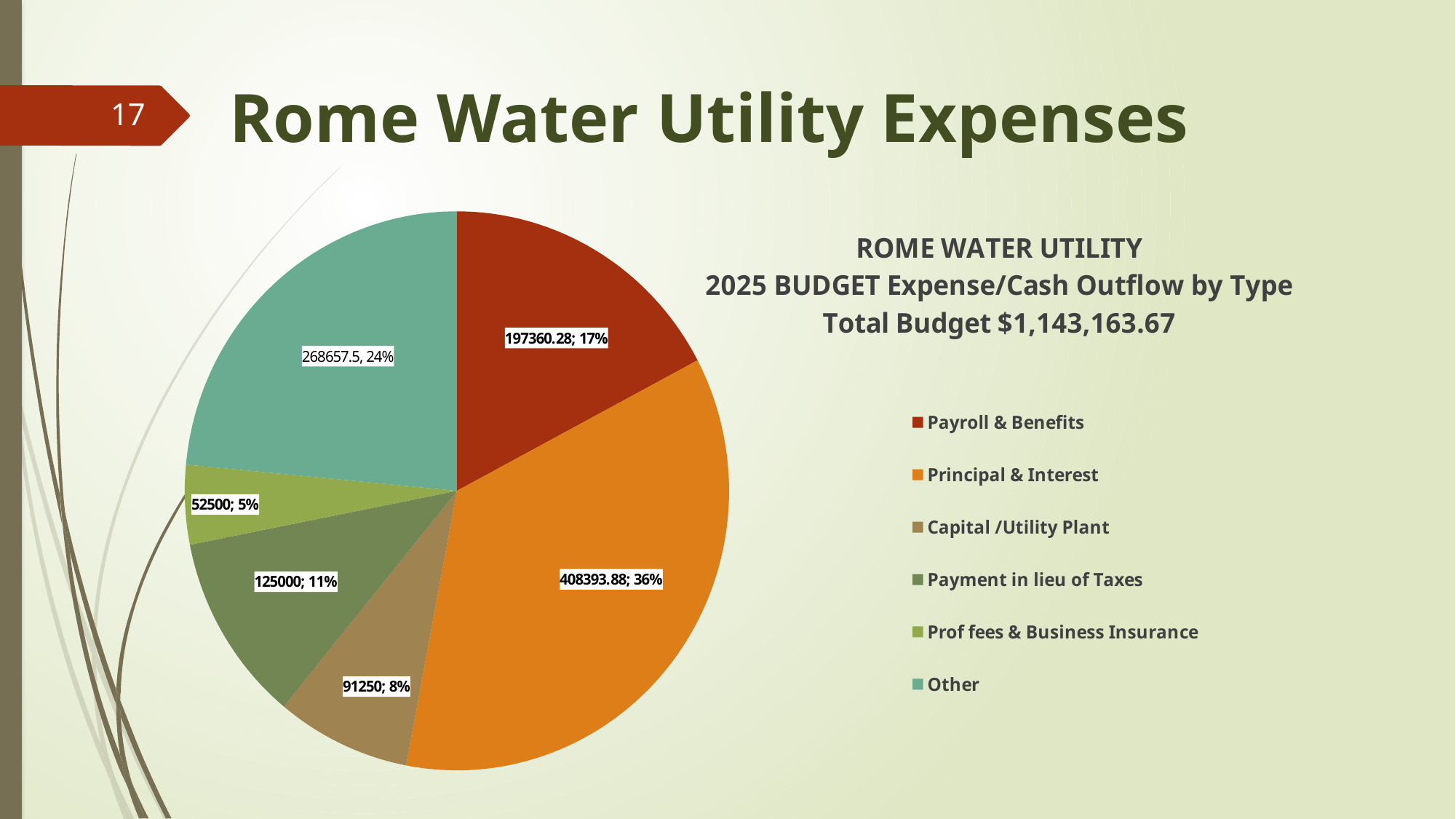
What is the value for Principal & Interest? 408393.88 What share of the pie does Prof fees & Business Insurance represent? 5% What is the difference between the values for Payment in lieu of Taxes and Prof fees & Business Insurance? 72500 What is the value for Payroll & Benefits? 197360.28 Which is larger, Other or Payroll & Benefits? Other Which category has the largest slice? Principal & Interest What is the value for Other? 268657.5 What share of the pie does Capital /Utility Plant represent? 8% What kind of chart is shown on the slide? Pie chart What is the value for Payment in lieu of Taxes? 125000 Which category has the smallest slice? Prof fees & Business Insurance How many categories does the legend list? 6